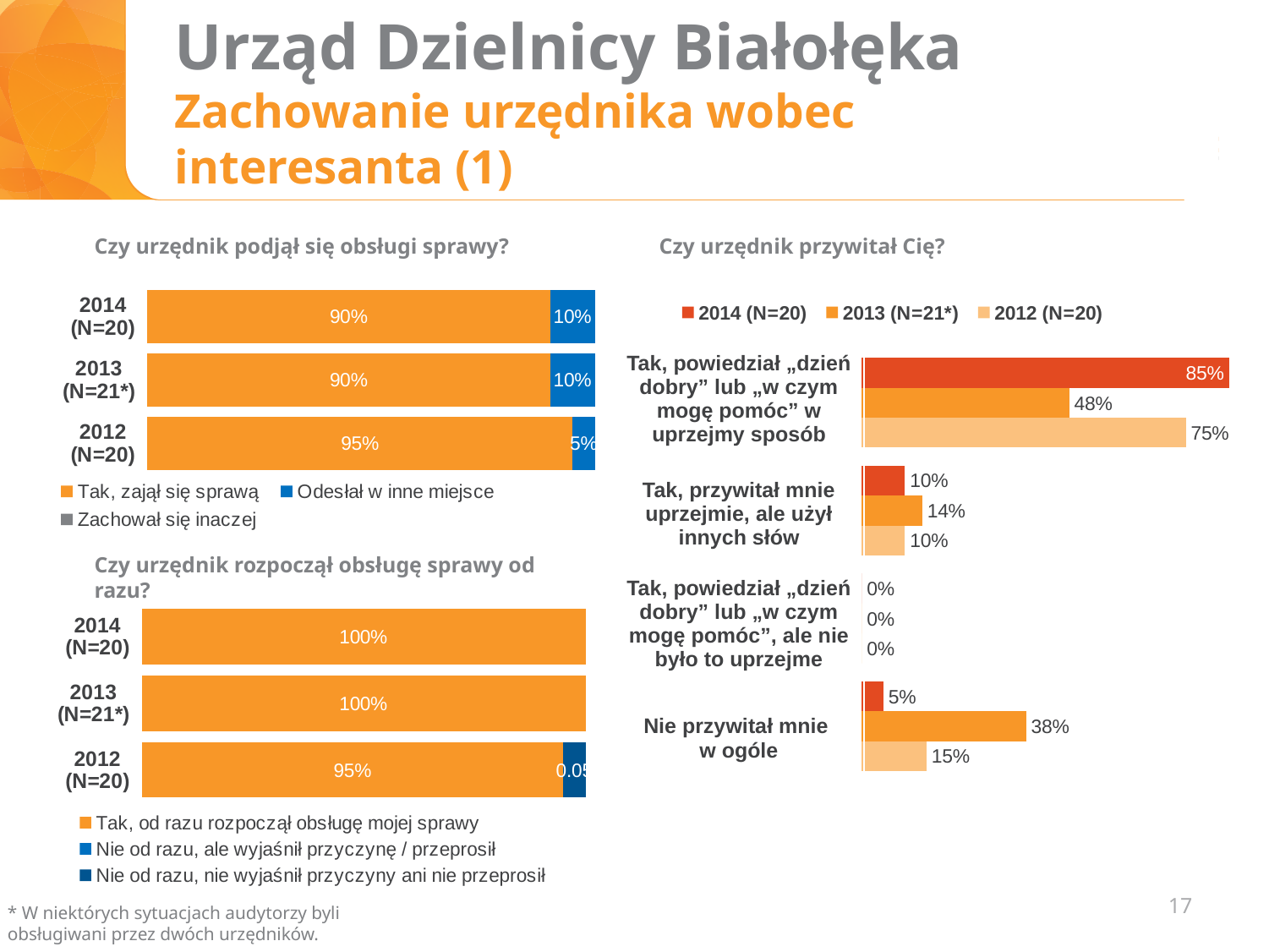
What kind of chart is "Czy urzędnik rozpoczął obsługę sprawy od razu?"? Stacked bar chart How many series does the legend of the chart "Czy urzędnik przywitał Cię?" list? 3 In the chart "Czy urzędnik przywitał Cię?", what is the difference between the 2014 and 2013 values for "Tak, powiedział „dzień dobry” lub „w czym mogę pomóc” w uprzejmy sposób"? 37 percentage points In the chart "Czy urzędnik przywitał Cię?", which year has the highest value for "Nie przywitał mnie w ogóle"? 2013 (N=21*) In the chart "Czy urzędnik przywitał Cię?", what is the value for 2013 (N=21*) in the category "Nie przywitał mnie w ogóle"? 38% In the chart "Czy urzędnik przywitał Cię?", what is the value for 2014 (N=20) in the category "Tak, powiedział „dzień dobry” lub „w czym mogę pomóc” w uprzejmy sposób"? 85% In the chart "Czy urzędnik podjął się obsługi sprawy?", what is the value of "Odesłał w inne miejsce" for 2014 (N=20)? 10% In the chart "Czy urzędnik podjął się obsługi sprawy?", what is the value of "Tak, zajął się sprawą" for 2012 (N=20)? 95% In the chart "Czy urzędnik rozpoczął obsługę sprawy od razu?", what is the value of "Tak, od razu rozpoczął obsługę mojej sprawy" for 2013 (N=21*)? 100% In the chart "Czy urzędnik przywitał Cię?", is the 2012 value for "Tak, przywitał mnie uprzejmie, ale użył innych słów" larger or smaller than the 2013 value? Smaller How many categories are shown in the chart "Czy urzędnik przywitał Cię?"? 4 In the chart "Czy urzędnik przywitał Cię?", which year has the lowest value for "Tak, powiedział „dzień dobry” lub „w czym mogę pomóc” w uprzejmy sposób"? 2013 (N=21*)